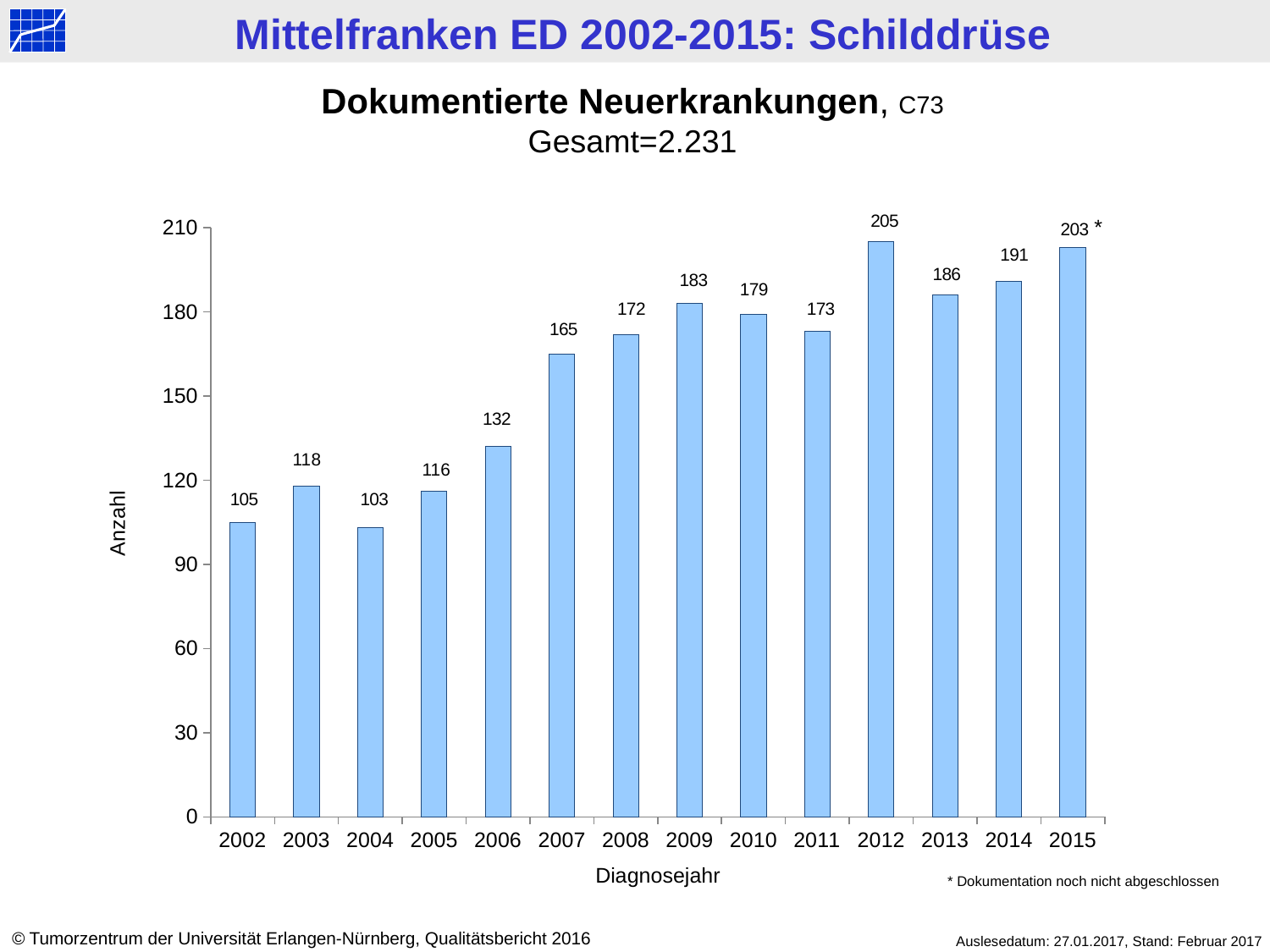
Which year has the lowest number of documented new cases? 2004 Which year has the highest number of documented new cases? 2012 What is the difference between the values for 2015 and 2014? 12 What kind of chart is shown on the slide? Bar chart How many years (categories) are shown on the x axis? 14 Do the values generally rise or fall from 2002 to 2015? Rise What is the value shown for the year 2004? 103 What is the number of documented new cases (Anzahl) for 2009? 183 Is the value for 2006 greater or less than 120? greater Which year has a larger value, 2010 or 2011? 2010 What is the label of the x axis? Diagnosejahr What is the difference between the values for 2012 and 2002? 100